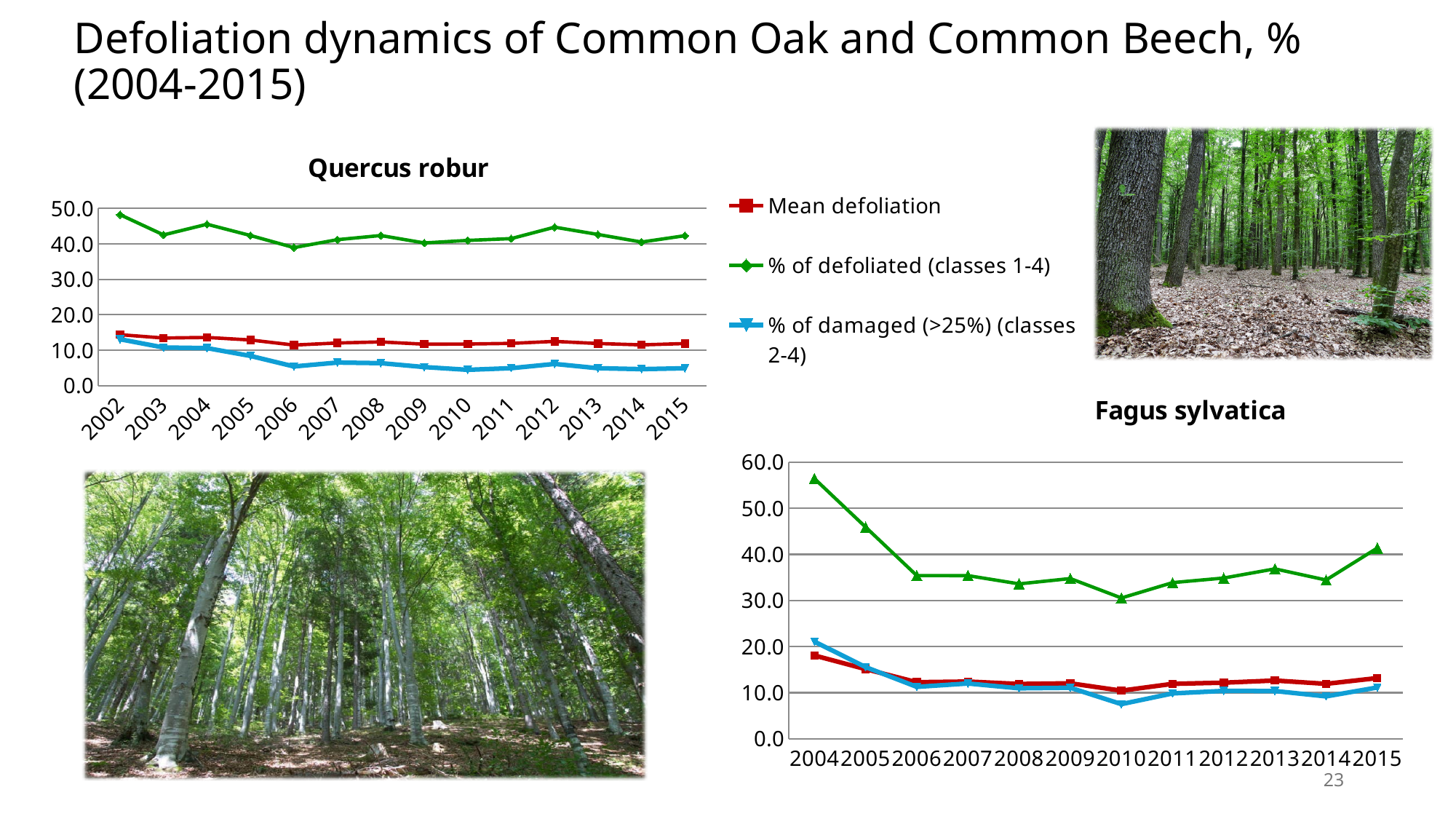
How many years are plotted on the x axis of the Fagus sylvatica chart? 12 In the Fagus sylvatica chart, is the % of defoliated (classes 1-4) in 2004 greater or less than 50.0? greater In the Quercus robur chart, is the % of damaged (>25%) (classes 2-4) in 2002 greater or less than 10.0? greater In the Fagus sylvatica chart, does the % of defoliated (classes 1-4) rise or fall from 2004 to 2006? fall In the Fagus sylvatica chart, in which year is the % of defoliated (classes 1-4) highest? 2004 What kind of chart is the Quercus robur chart? line chart How many years are plotted on the x axis of the Quercus robur chart? 14 In the Fagus sylvatica chart, in which year is the % of defoliated (classes 1-4) lowest? 2010 In the Quercus robur chart, in which year is the % of defoliated (classes 1-4) lowest? 2006 In the Fagus sylvatica chart, is the % of defoliated (classes 1-4) in 2010 greater or less than 40.0? less In the Quercus robur chart, in which year is the % of defoliated (classes 1-4) highest? 2002 How many series does the legend list? 3